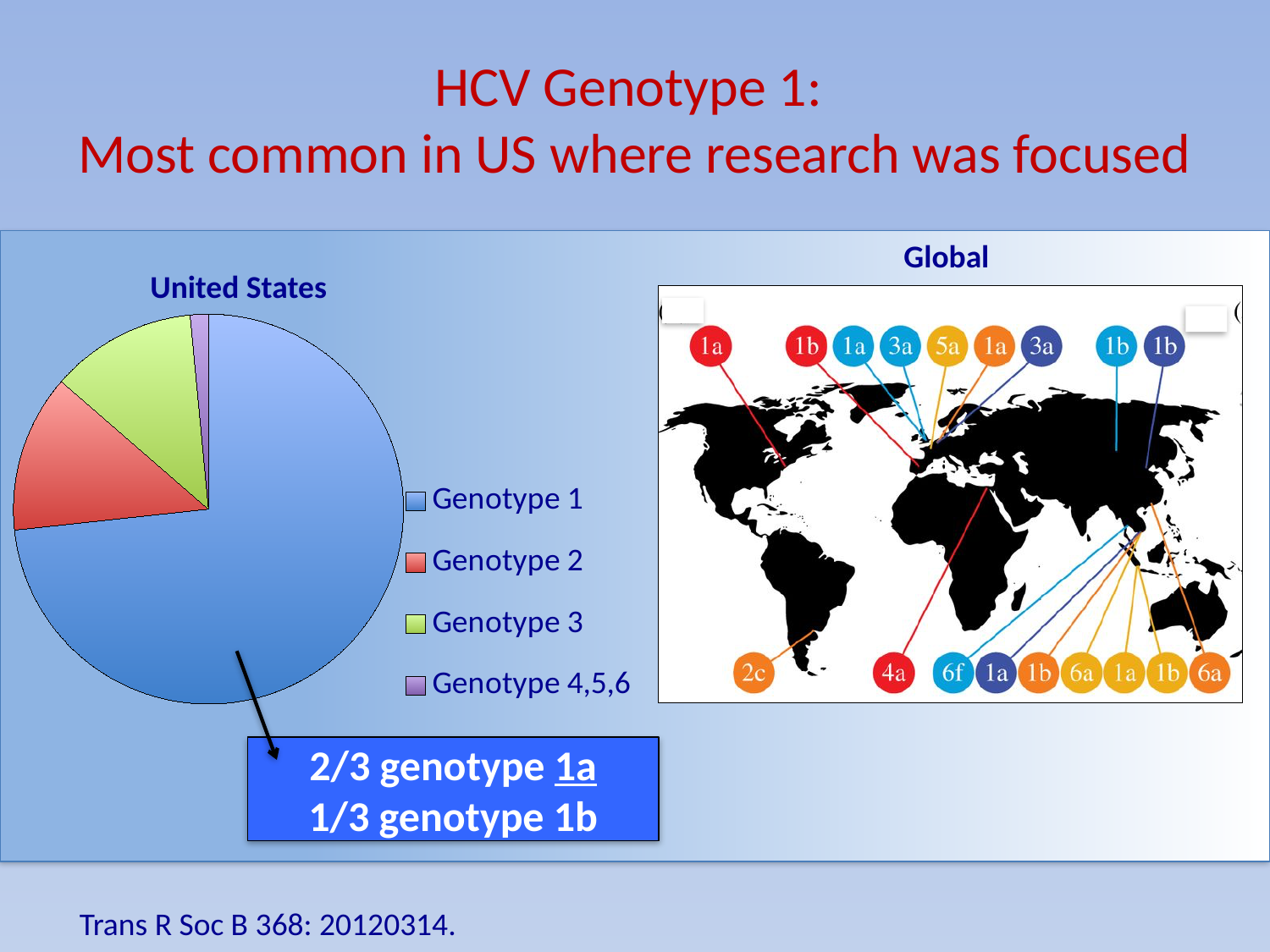
In the United States pie chart, what colour is the Genotype 1 slice? blue How many categories does the United States pie chart show? 4 In the United States pie chart, which category has the smallest slice? Genotype 4,5,6 In the United States pie chart, which genotype has the largest slice? Genotype 1 What kind of chart is the United States chart on the slide? pie chart In the United States pie chart, which slice is larger: Genotype 3 or Genotype 4,5,6? Genotype 3 How many entries does the legend of the United States pie chart list? 4 In the United States pie chart, does Genotype 1 account for more or less than half of the pie? more In the United States pie chart, which slice is larger: Genotype 1 or Genotype 2? Genotype 1 What is the title of the pie chart on the left of the slide? United States